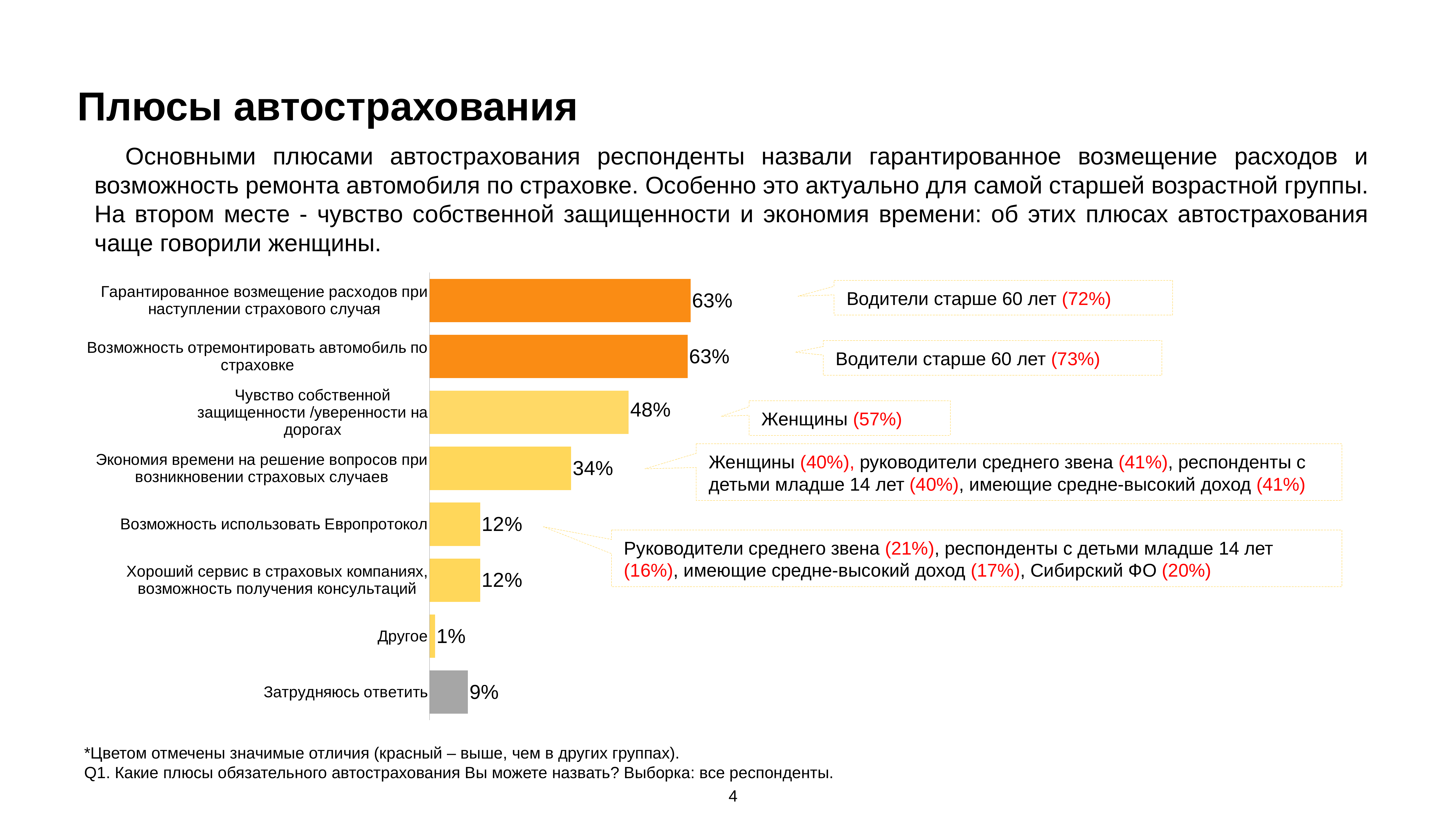
What value is shown for "Экономия времени на решение вопросов при возникновении страховых случаев"? 34% What colour is the bar for "Затрудняюсь ответить"? Grey What is the difference between the values for "Чувство собственной защищенности /уверенности на дорогах" and "Экономия времени на решение вопросов при возникновении страховых случаев"? 14% Which category has the lowest value in the chart? Другое What kind of chart is shown on the slide? Bar chart What value is shown for "Возможность использовать Европротокол"? 12% What value is shown for "Возможность отремонтировать автомобиль по страховке"? 63% Which is larger: the value for "Затрудняюсь ответить" or the value for "Другое"? Затрудняюсь ответить What value is shown for "Затрудняюсь ответить"? 9% What value is shown for "Чувство собственной защищенности /уверенности на дорогах"? 48% What is the difference between the values for "Гарантированное возмещение расходов при наступлении страхового случая" and "Чувство собственной защищенности /уверенности на дорогах"? 15% How many categories are shown in the chart? 8